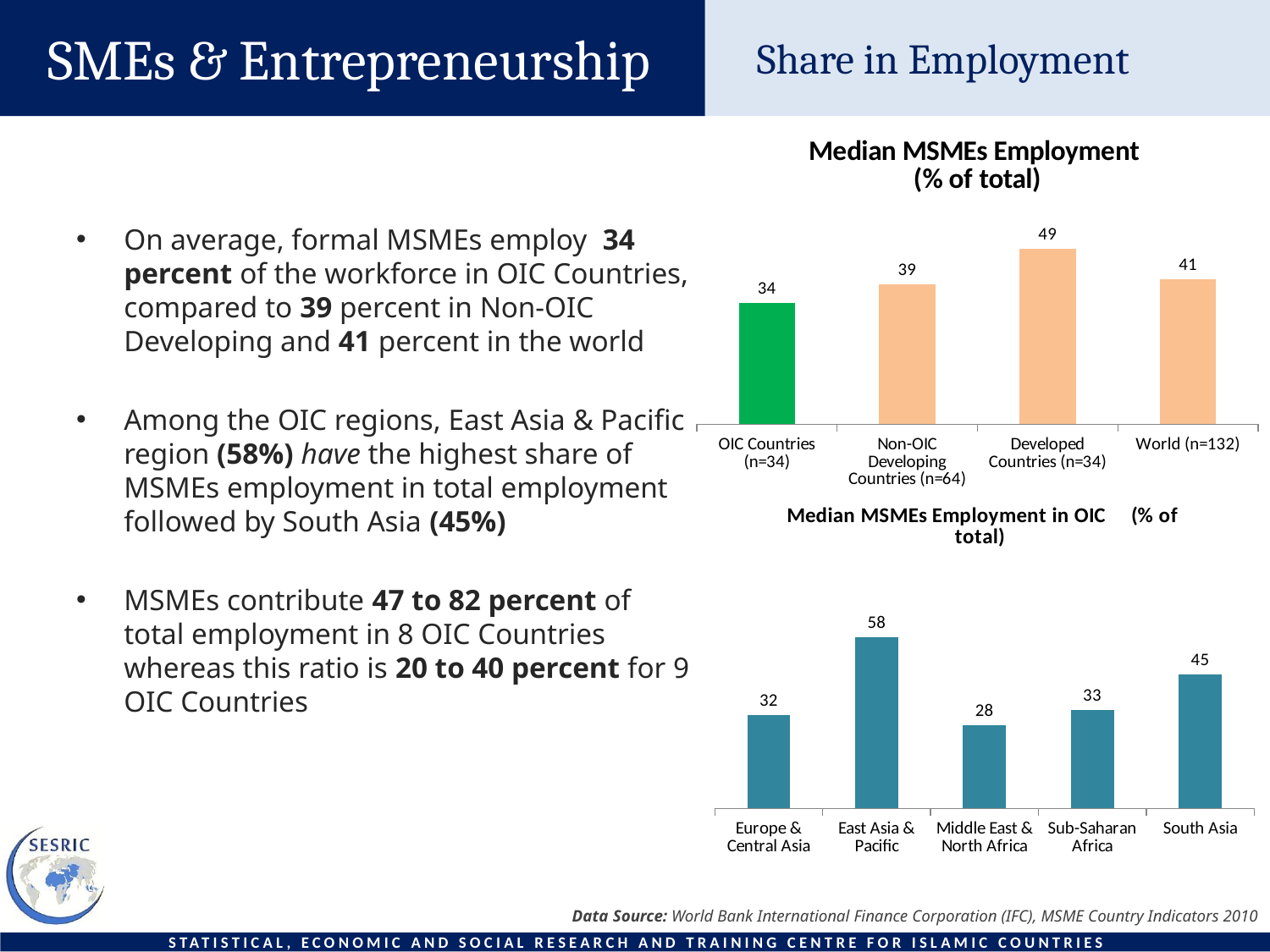
In the 'Median MSMEs Employment in OIC (% of total)' chart, what is the value for Middle East & North Africa? 28 In the 'Median MSMEs Employment (% of total)' chart, which category has the highest value? Developed Countries (n=34) In the 'Median MSMEs Employment (% of total)' chart, what is the difference between Developed Countries (n=34) and World (n=132)? 8 What type of chart is the 'Median MSMEs Employment in OIC (% of total)' chart? Bar chart In the 'Median MSMEs Employment in OIC (% of total)' chart, what is the difference between East Asia & Pacific and South Asia? 13 In the 'Median MSMEs Employment (% of total)' chart, which category has the lowest value? OIC Countries (n=34) In the 'Median MSMEs Employment (% of total)' chart, what is the value for OIC Countries (n=34)? 34 In the 'Median MSMEs Employment in OIC (% of total)' chart, which region has the highest value? East Asia & Pacific In the 'Median MSMEs Employment (% of total)' chart, how many categories are shown? 4 In the 'Median MSMEs Employment (% of total)' chart, which bar is shown in green? OIC Countries (n=34) In the 'Median MSMEs Employment in OIC (% of total)' chart, which is larger, Europe & Central Asia or Sub-Saharan Africa? Sub-Saharan Africa In the 'Median MSMEs Employment in OIC (% of total)' chart, which region has the lowest value? Middle East & North Africa